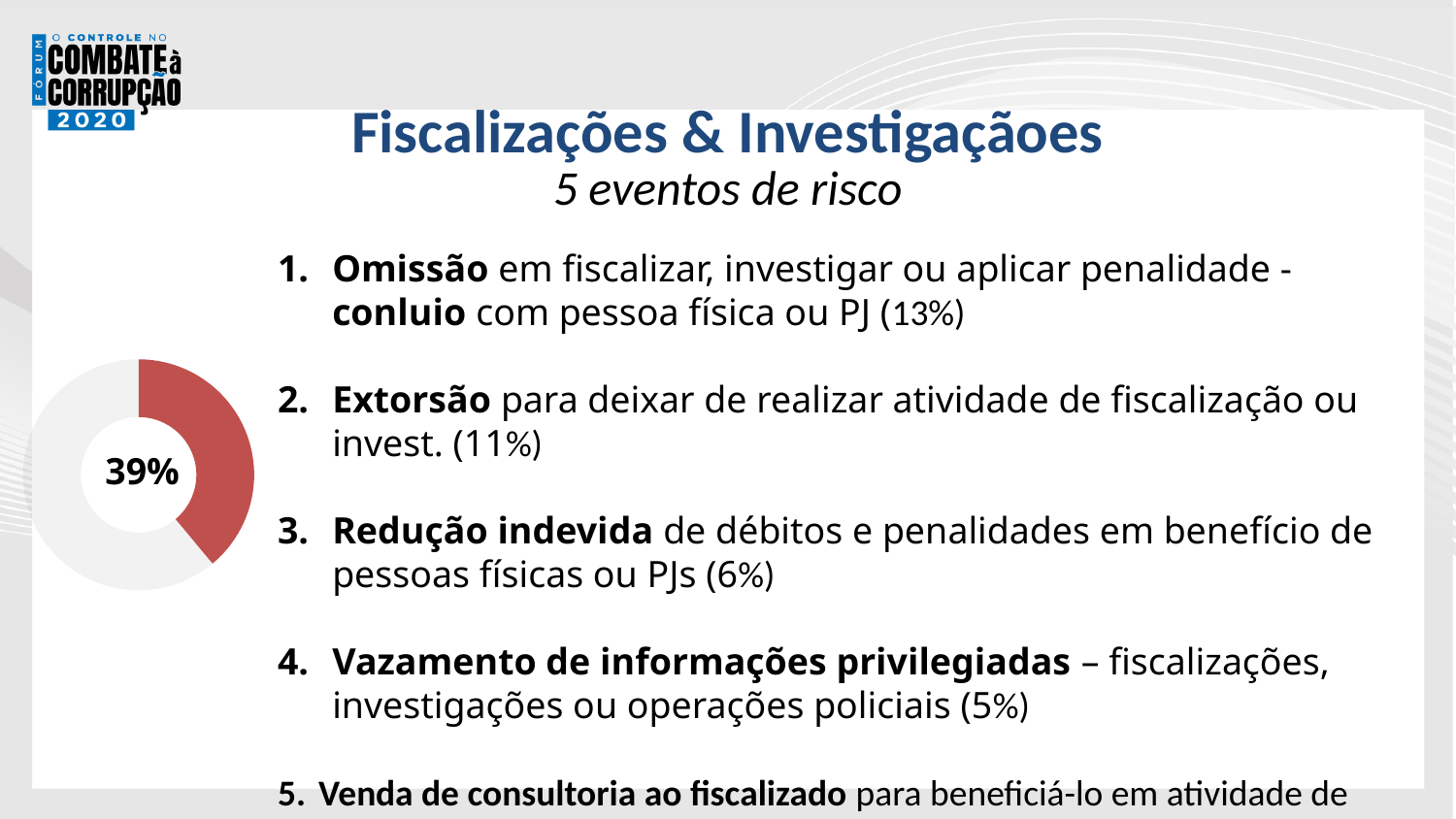
Does the donut chart have a legend? No How many segments does the donut chart have? 2 What percentage is printed in the centre of the donut chart? 39% What share of the donut chart does the red segment represent? 39% What kind of chart is shown on the left of the slide? Donut chart What colour is the segment of the donut chart that corresponds to the 39% value? Red Which segment of the donut chart is larger, the red one or the grey one? the grey one Is the red segment of the donut chart greater or less than 50%? less